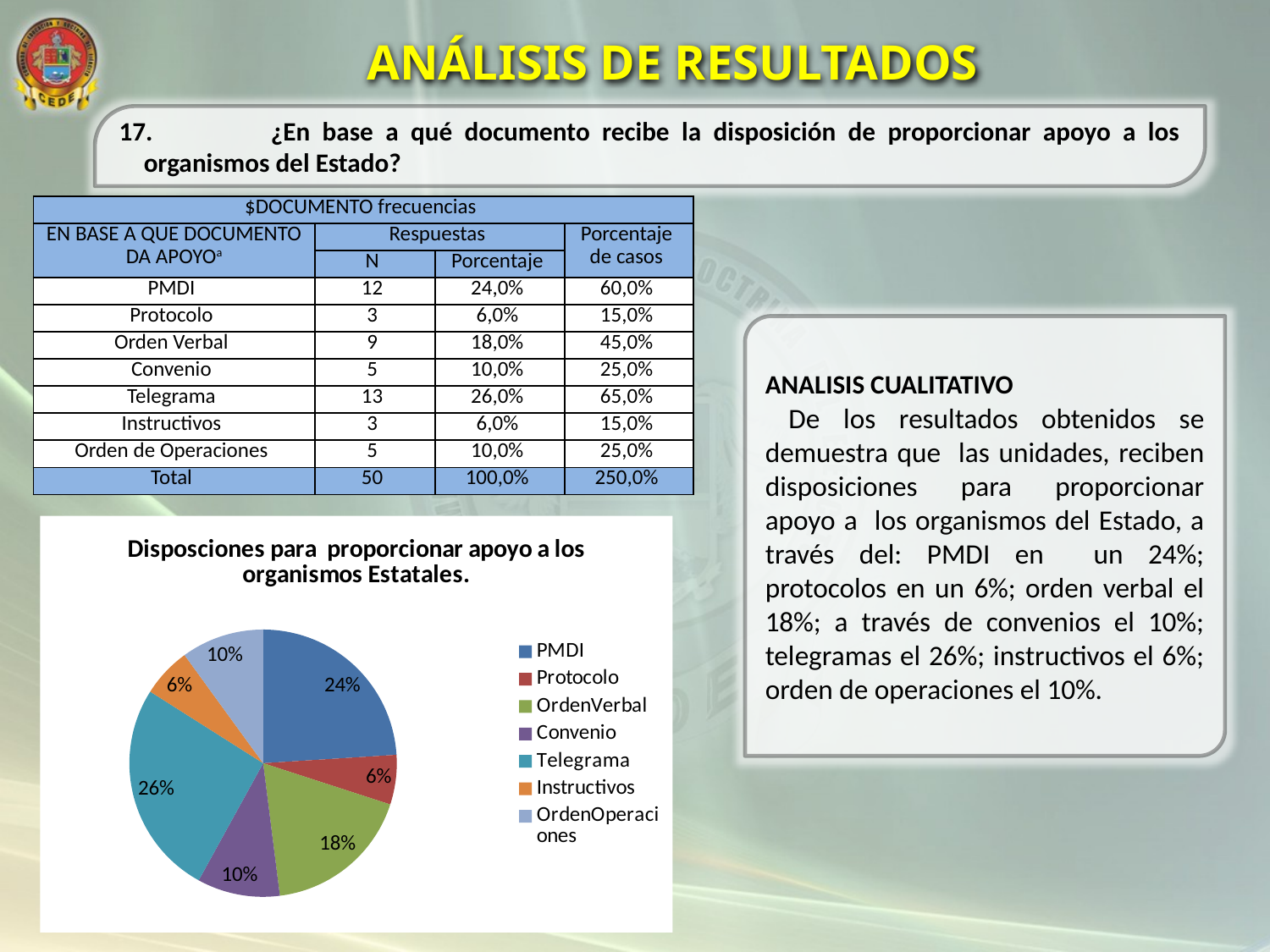
What is the difference in percentage points between the Telegrama share and the Convenio share? 16 What is the title of the chart? Disposciones para proporcionar apoyo a los organismos Estatales. What percentage of the pie does OrdenVerbal represent? 18% What is the combined share of PMDI and Telegrama? 50% What percentage of the pie does Telegrama represent? 26% What percentage of the pie does PMDI represent? 24% What percentage of the pie does Convenio represent? 10% Which is larger, the share for PMDI or the share for OrdenVerbal? PMDI What type of chart is shown on the slide? pie chart Which legend entry is shown in orange? Instructivos Which category has the largest share of the pie? Telegrama How many categories does the legend list? 7